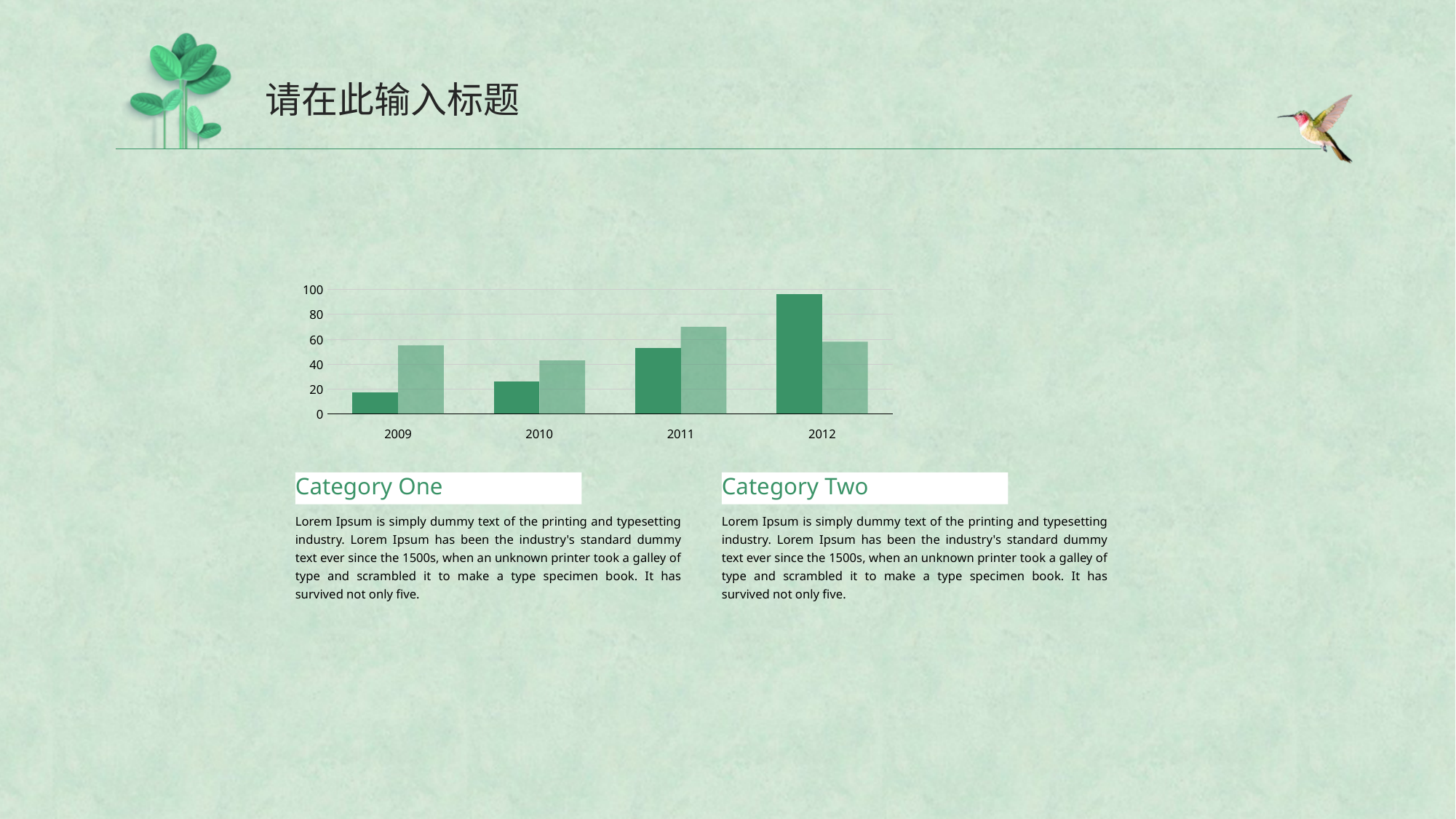
In 2010, which bar is taller, the dark green or the light green? light green Which year has the tallest dark green bar? 2012 Do the dark green bars rise or fall from 2009 to 2012? rise Is the dark green bar for 2012 greater or less than 80? greater Which year has the shortest dark green bar? 2009 How many years are shown on the x axis of the chart? 4 Is the dark green bar for 2009 greater or less than 20? less Which year has the shortest light green bar? 2010 Is the light green bar for 2011 greater or less than 60? greater Which year has the tallest light green bar? 2011 What kind of chart is shown on the slide? bar chart In 2012, which bar is taller, the dark green or the light green? dark green